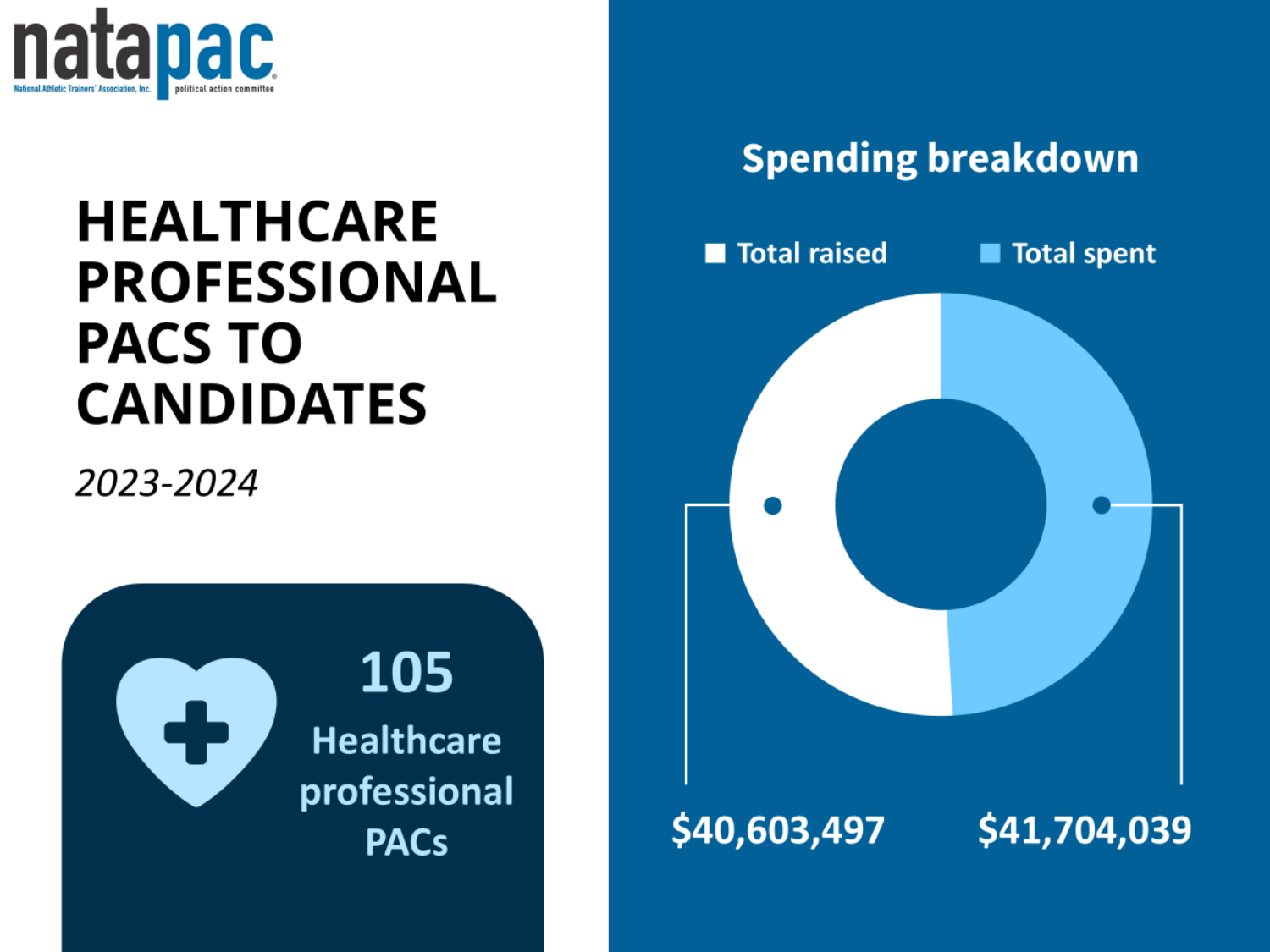
In the Spending breakdown chart, is Total spent larger or smaller than Total raised? Larger What kind of chart is the Spending breakdown chart? Donut (pie) chart Which slice of the Spending breakdown chart has the smaller value? Total raised What is the title of the chart on the slide? Spending breakdown What is the difference between Total spent and Total raised in the Spending breakdown chart? $1,100,542 What colour represents Total spent in the Spending breakdown chart? Light blue What is the value for Total raised in the Spending breakdown chart? $40,603,497 How many series does the legend of the Spending breakdown chart list? 2 How many slices does the Spending breakdown chart have? 2 Which slice of the Spending breakdown chart has the larger value? Total spent What is the value for Total spent in the Spending breakdown chart? $41,704,039